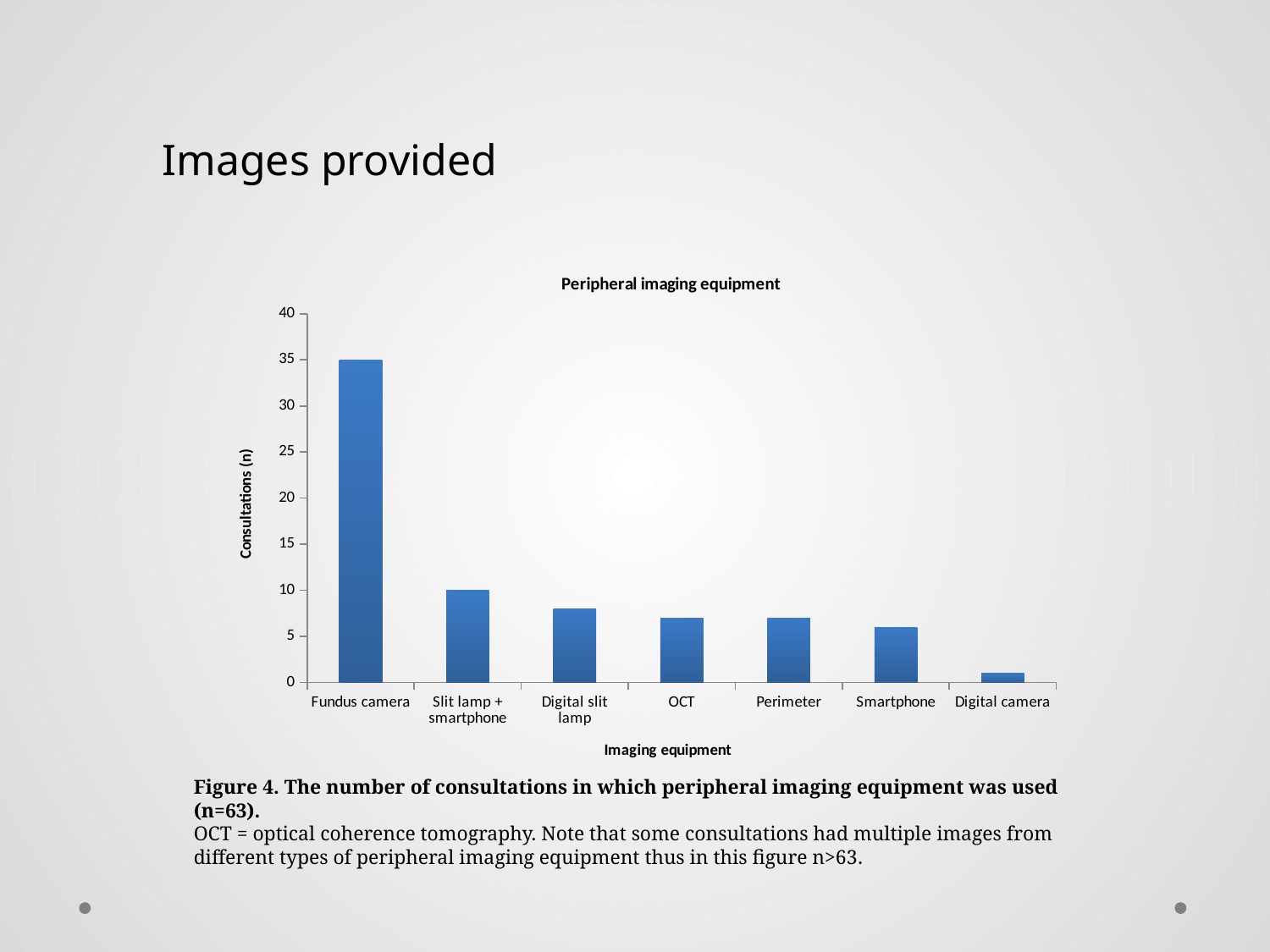
How many consultations used a Fundus camera? 35 What is the title of the chart? Peripheral imaging equipment How many consultations used Slit lamp + smartphone? 10 Do the values generally rise or fall from left to right along the x axis? fall Which imaging equipment has the highest number of consultations? Fundus camera Is the value for Digital slit lamp greater or less than 5? greater Which imaging equipment has the lowest number of consultations? Digital camera Is the value for Digital camera greater or less than 5? less Which has more consultations, Fundus camera or Slit lamp + smartphone? Fundus camera What is the difference in consultations between Fundus camera and Slit lamp + smartphone? 25 How many imaging equipment categories are shown on the x axis? 7 What type of chart is shown on the slide? bar chart